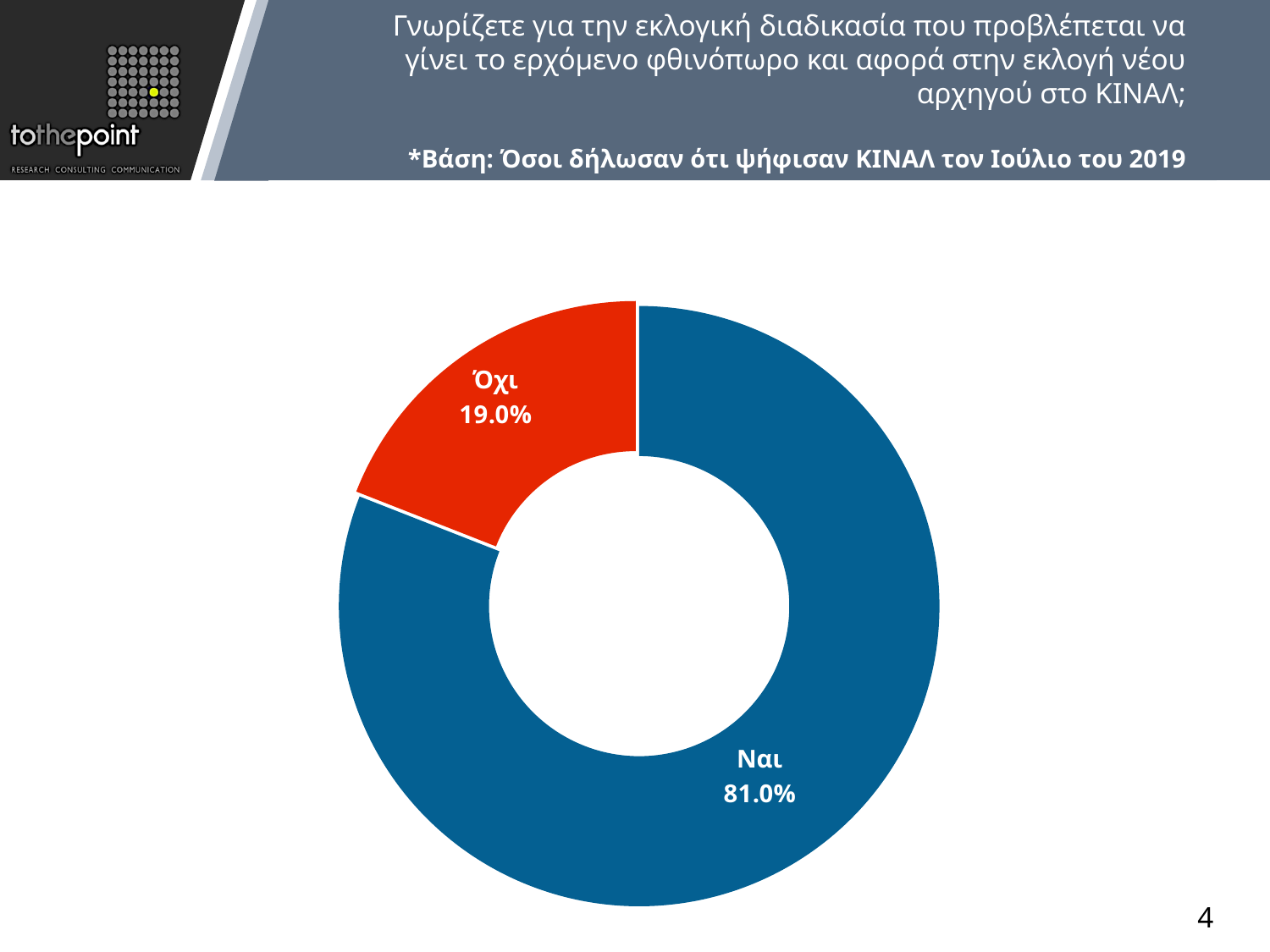
What is the difference in percentage points between Ναι and Όχι? 62.0 What colour is the Ναι slice? Blue What is the total of the two percentages shown in the chart? 100.0% Which response has the smallest share of the chart? Όχι What colour is the Όχι slice? Red Which is larger, the share for Ναι or the share for Όχι? Ναι What percentage of respondents answered Ναι? 81.0% How many categories are shown in the chart? 2 Which response has the largest share of the chart? Ναι What kind of chart is shown on the slide? Pie chart (doughnut) What percentage of respondents answered Όχι? 19.0%